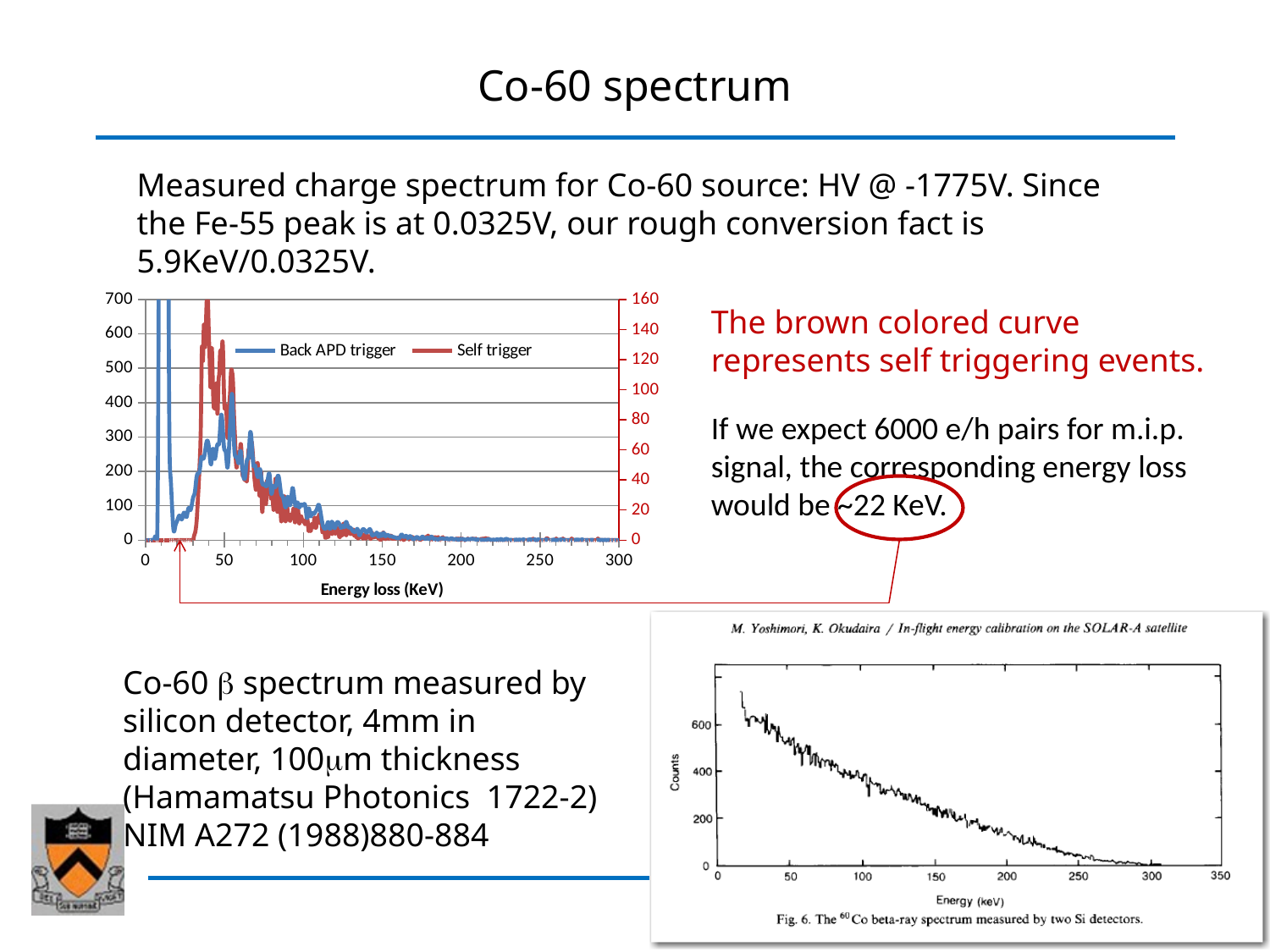
In the lower-right Fig. 6 chart, is the count value at 50 keV greater or less than 400? greater In the upper-left Co-60 spectrum chart, is the Back APD trigger value at 200 KeV greater or less than 100 on the left axis? less What kind of chart is the Co-60 spectrum chart on the upper left of the slide? line chart In the lower-right Fig. 6 chart, is the count value at 250 keV greater or less than 200? less How many series does the legend of the upper-left Co-60 spectrum chart list? 2 In the lower-right Fig. 6 chart, do the counts rise or fall as energy increases from 50 keV to 300 keV? fall What kind of chart is the Fig. 6 Co beta-ray spectrum chart at the lower right of the slide? line chart In the upper-left Co-60 spectrum chart, do the Back APD trigger values rise or fall along the x axis from 100 KeV to 300 KeV? fall In the upper-left Co-60 spectrum chart, which series is drawn in red/brown? Self trigger What is the x-axis title of the upper-left Co-60 spectrum chart? Energy loss (KeV)